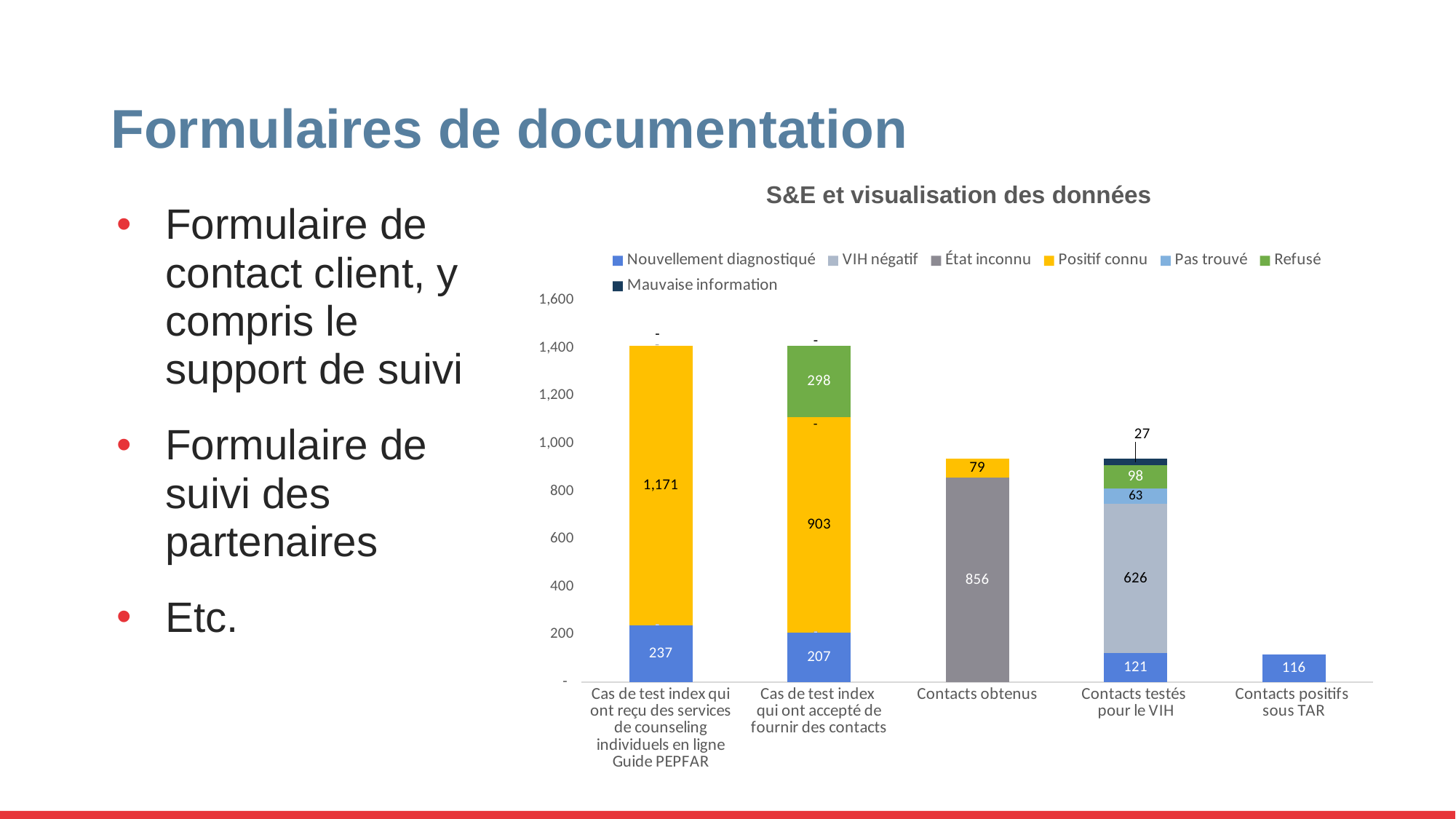
What is the value of 'État inconnu' for 'Contacts obtenus'? 856 What is the difference between the 'Positif connu' values for 'Cas de test index qui ont reçu des services de counseling individuels en ligne Guide PEPFAR' and 'Cas de test index qui ont accepté de fournir des contacts'? 268 Which category has the lowest total bar height? Contacts positifs sous TAR What is the value of 'Positif connu' for 'Cas de test index qui ont reçu des services de counseling individuels en ligne Guide PEPFAR'? 1,171 What type of chart is shown on the slide? Stacked bar chart What is the value of 'Refusé' for 'Cas de test index qui ont accepté de fournir des contacts'? 298 How many series does the chart legend list? 7 What is the title of the chart? S&E et visualisation des données What is the value of 'VIH négatif' for 'Contacts testés pour le VIH'? 626 What is the total of the stacked bar for 'Contacts testés pour le VIH'? 935 What is the value of 'Nouvellement diagnostiqué' for 'Contacts positifs sous TAR'? 116 How many categories are shown on the x axis of the chart? 5